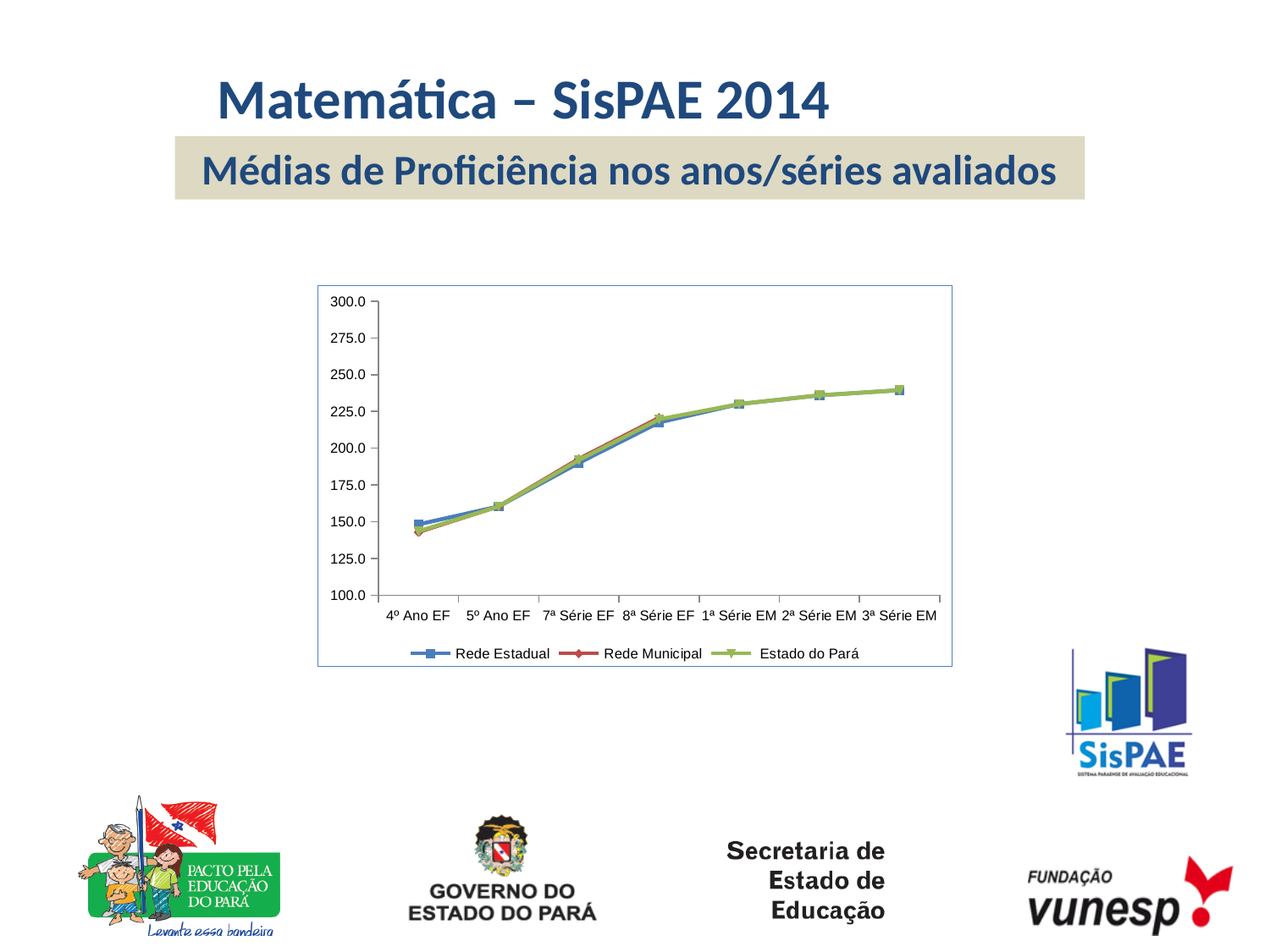
Is the value for Rede Estadual at 8ª Série EF greater or less than 200? greater How many years/series (categories) are plotted along the x axis? 7 Is the value for Rede Estadual at 7ª Série EF greater or less than 175? greater Is the value for Rede Municipal at 4º Ano EF greater or less than 150? less Do the proficiency averages rise or fall from 4º Ano EF to 3ª Série EM? rise Which series is shown in green in the legend? Estado do Pará Which category has the lowest proficiency averages? 4º Ano EF How many series does the legend list? 3 What subject and year does the slide title refer to? Matemática – SisPAE 2014 What kind of chart is shown on the slide? line chart